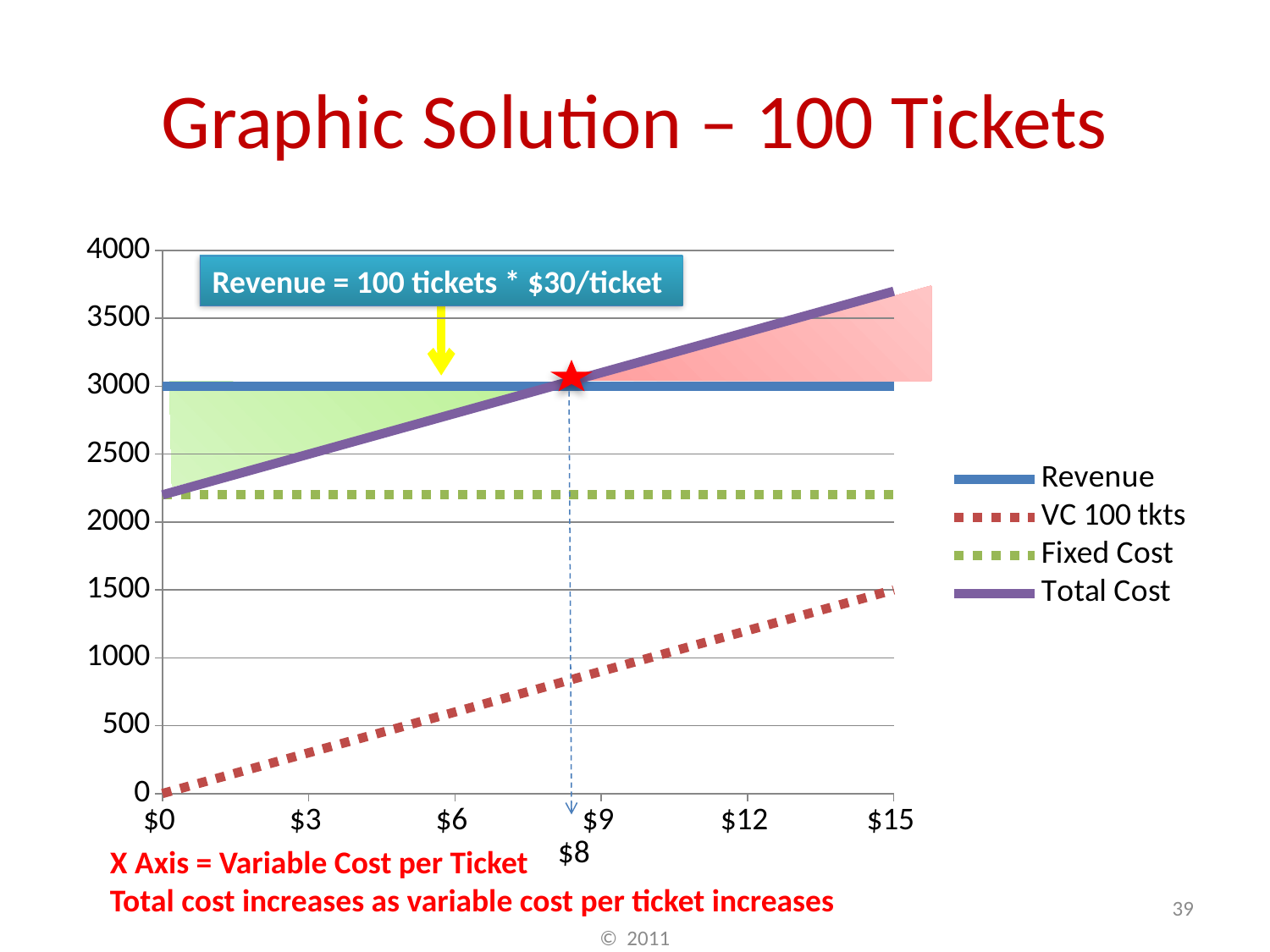
What is the title of the slide? Graphic Solution – 100 Tickets At what variable cost per ticket does Total Cost equal Revenue, as marked on the chart? $8 At $15 variable cost per ticket, which is larger: Total Cost or Revenue? Total Cost Is the value of the Fixed Cost line greater or less than 2500? less Does Total Cost rise or fall as variable cost per ticket increases along the x axis? rises What is the value of VC 100 tkts at $0 variable cost per ticket? 0 What kind of chart is shown on the slide? line chart At $3 variable cost per ticket, which is larger: Revenue or Total Cost? Revenue Is the value of Total Cost at $15 greater or less than 3500? greater What is the value of VC 100 tkts at $15 variable cost per ticket? 1500 What is the value of the Revenue line? 3000 How many series does the legend list? 4